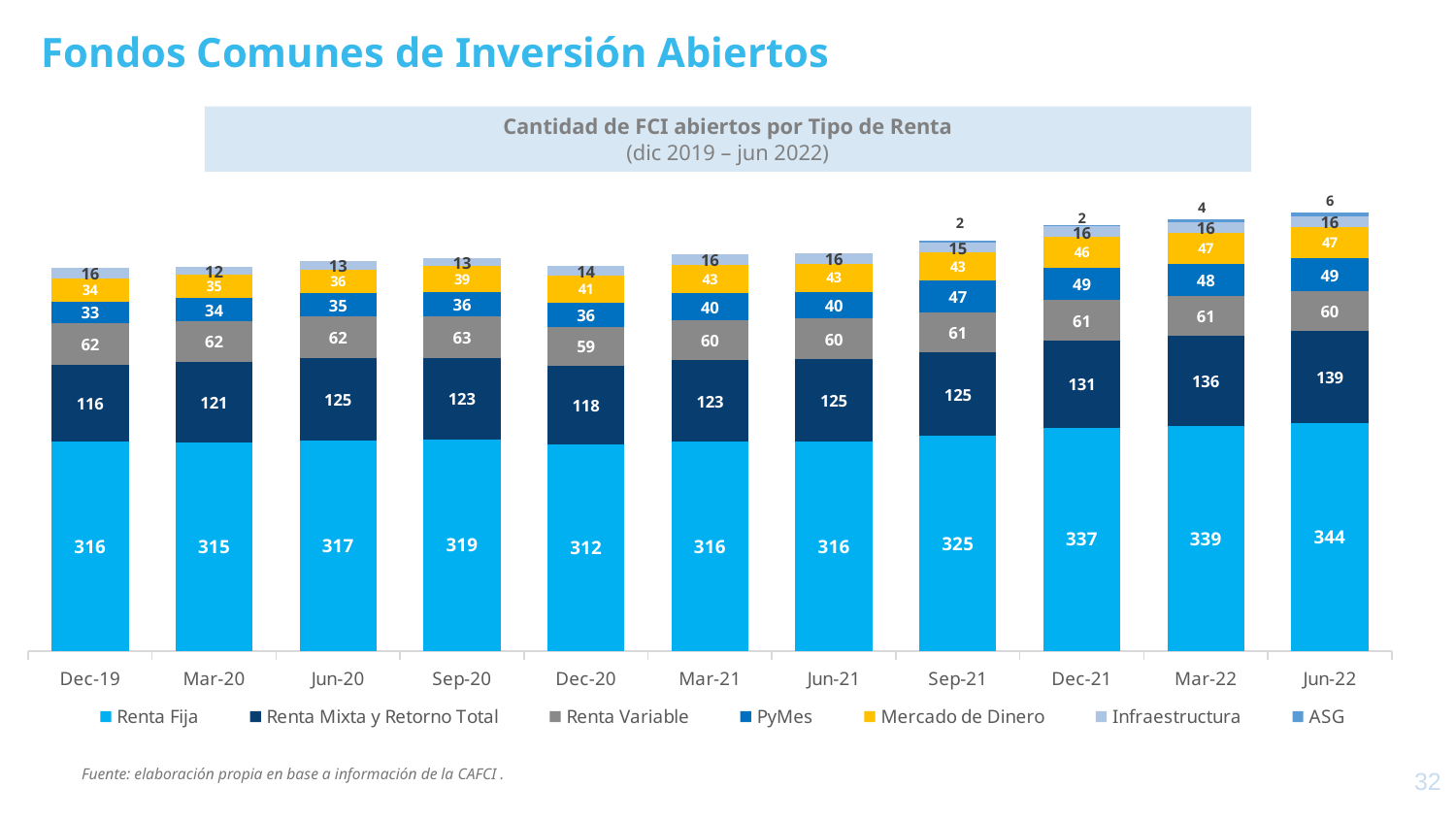
What is the total of the stacked bar for Jun-22? 661 In which period is the Renta Fija value highest? Jun-22 What is the value for ASG in Mar-22? 4 What kind of chart is shown on the slide? Stacked bar chart How many series does the legend list? 7 What is the value for Renta Fija in Jun-22? 344 How many periods are shown on the x axis? 11 In which period is the Renta Fija value lowest? Dec-20 What is the difference between the Renta Mixta y Retorno Total value in Jun-22 and in Dec-19? 23 What is the value for Renta Variable in Dec-20? 59 Does the Renta Fija value rise or fall from Sep-21 to Jun-22? Rise Which is larger: the Mercado de Dinero value in Dec-19 or in Jun-22? Jun-22